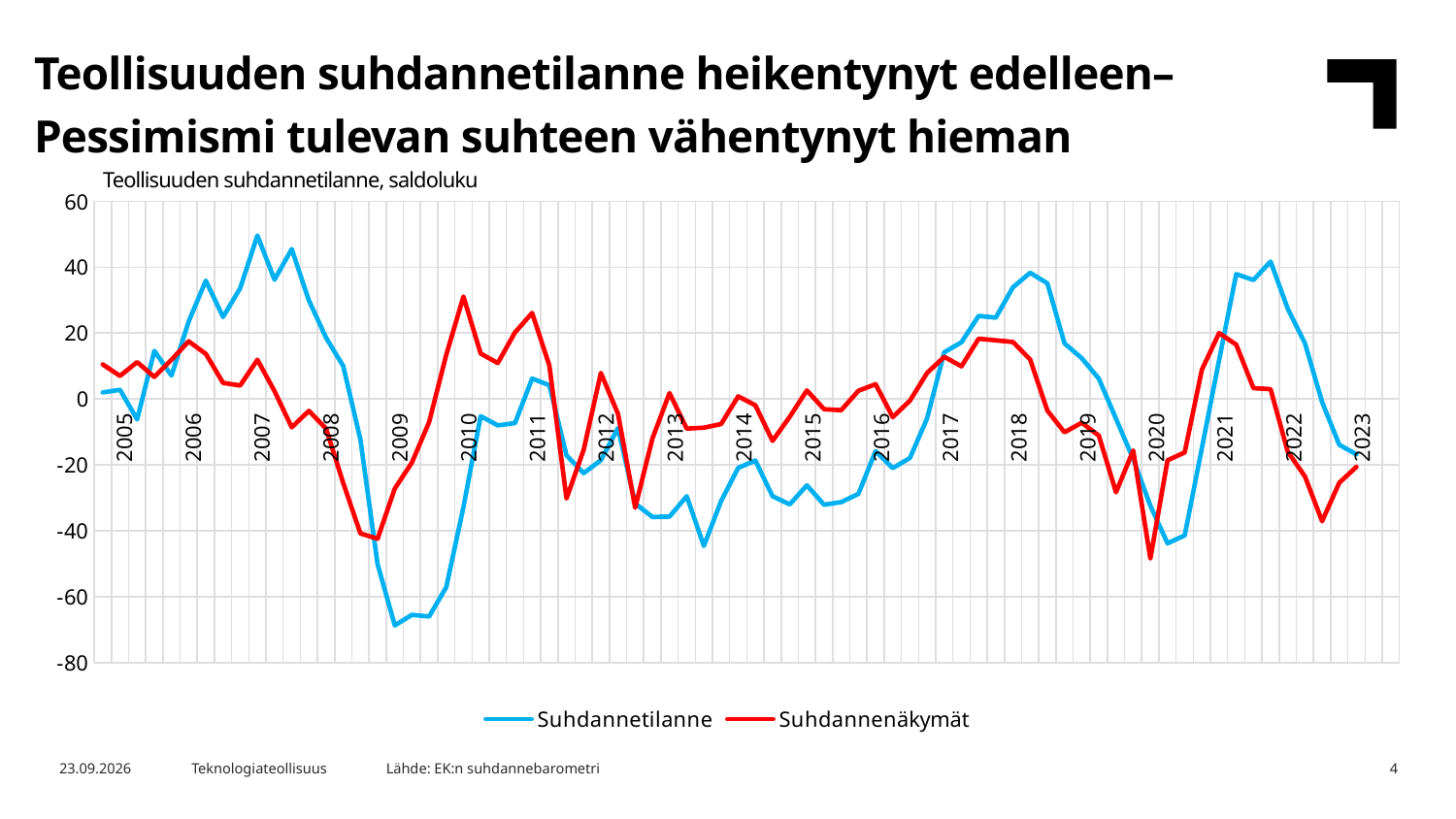
Which series reaches the highest value anywhere on the chart? Suhdannetilanne What kind of chart is shown on the slide? line chart How many year labels are shown on the x axis? 19 What are the two series named in the legend? Suhdannetilanne and Suhdannenäkymät Which series reaches the lowest value anywhere on the chart? Suhdannetilanne Does the Suhdannetilanne line rise or fall from its 2021 peak to 2023? fall Is the peak of the Suhdannenäkymät line around 2010 greater or less than 20? greater Is the peak of the Suhdannetilanne line around 2007 greater or less than 40? greater Is the lowest value of the Suhdannenäkymät line, reached around 2020, greater or less than -40? less What is the title printed above the chart? Teollisuuden suhdannetilanne, saldoluku How many series does the legend list? 2